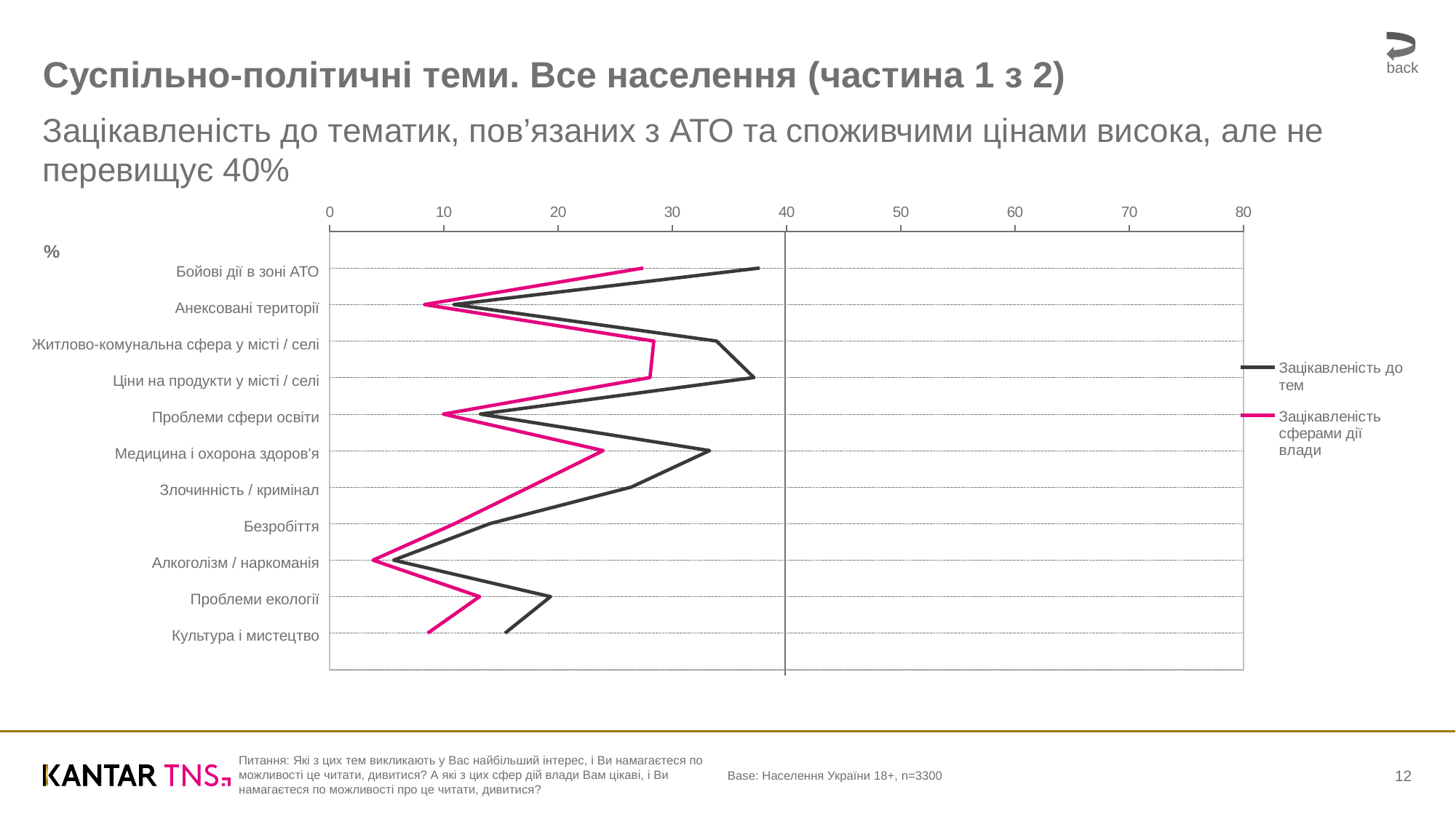
How many series does the legend list? 2 What colour is the line for the series "Зацікавленість сферами дії влади"? Pink (magenta) Is the value of "Зацікавленість до тем" for "Алкоголізм / наркоманія" greater or less than 10? less Is the value of "Зацікавленість до тем" for "Бойові дії в зоні АТО" greater or less than 30? greater For the series "Зацікавленість до тем", which is larger: "Медицина і охорона здоров'я" or "Злочинність / кримінал"? Медицина і охорона здоров'я Which topic has the lowest value for the series "Зацікавленість до тем"? Алкоголізм / наркоманія How many topics (categories) are listed on the chart? 11 Which topic has the lowest value for the series "Зацікавленість сферами дії влади"? Алкоголізм / наркоманія What kind of chart is shown on the slide? Line chart Is the value of "Зацікавленість до тем" for "Бойові дії в зоні АТО" greater or less than 40? less For "Медицина і охорона здоров'я", which series has the larger value: "Зацікавленість до тем" or "Зацікавленість сферами дії влади"? Зацікавленість до тем